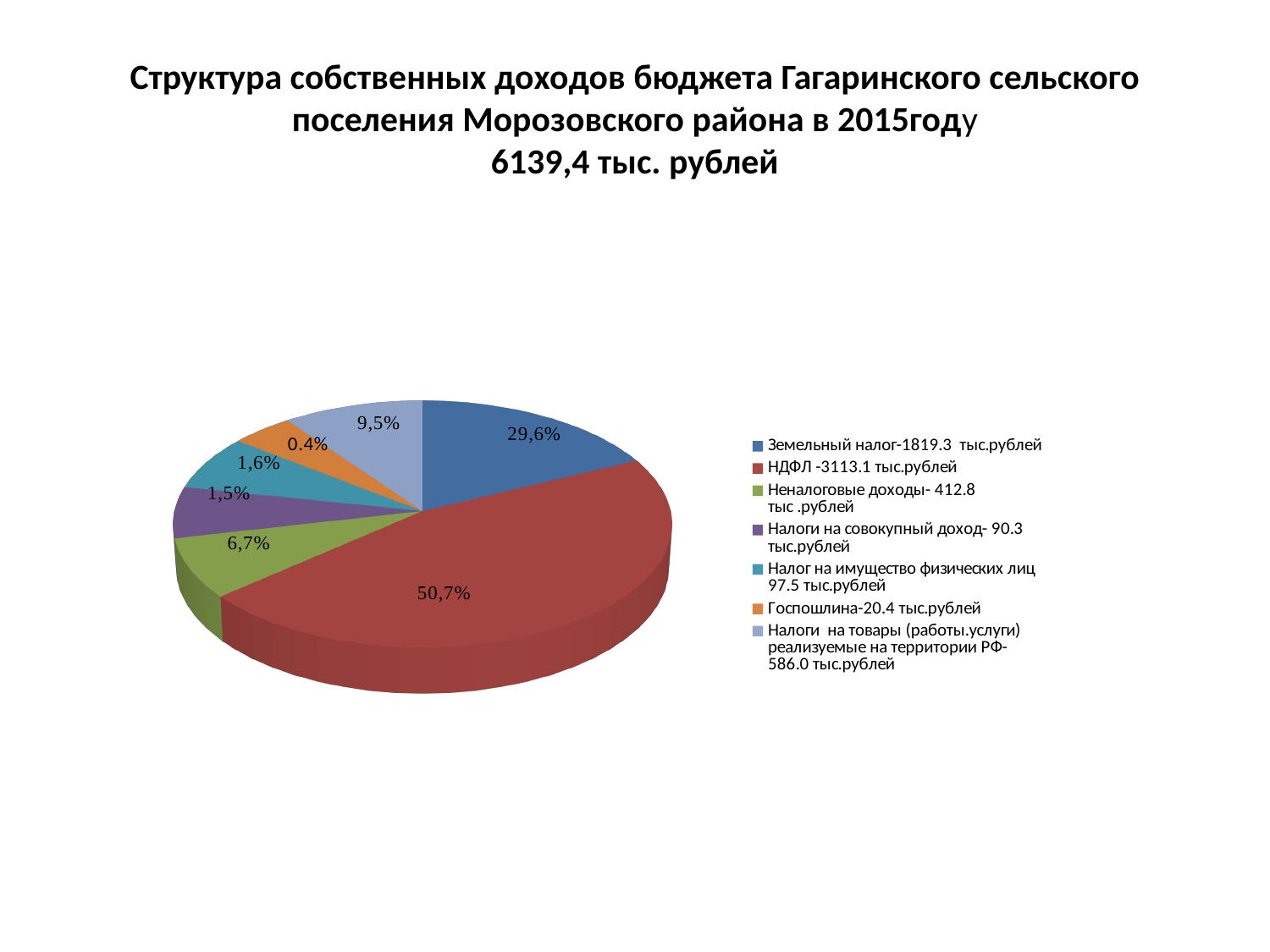
What percentage is shown for Неналоговые доходы? 6,7% What percentage is shown for Налоги на товары (работы, услуги) реализуемые на территории РФ? 9,5% Which is larger: the share for Земельный налог or the share for Неналоговые доходы? Земельный налог Which category has the largest share of the pie? НДФЛ What kind of chart is shown on the slide? pie chart What percentage is shown for Госпошлина? 0.4% What share of the pie does Земельный налог account for? 29,6% What total amount in thousand rubles is stated in the chart title? 6139,4 тыс. рублей How many entries does the legend list? 7 What share of the pie does НДФЛ account for? 50,7% Which category has the smallest share of the pie? Госпошлина How many slices does the pie chart have? 7